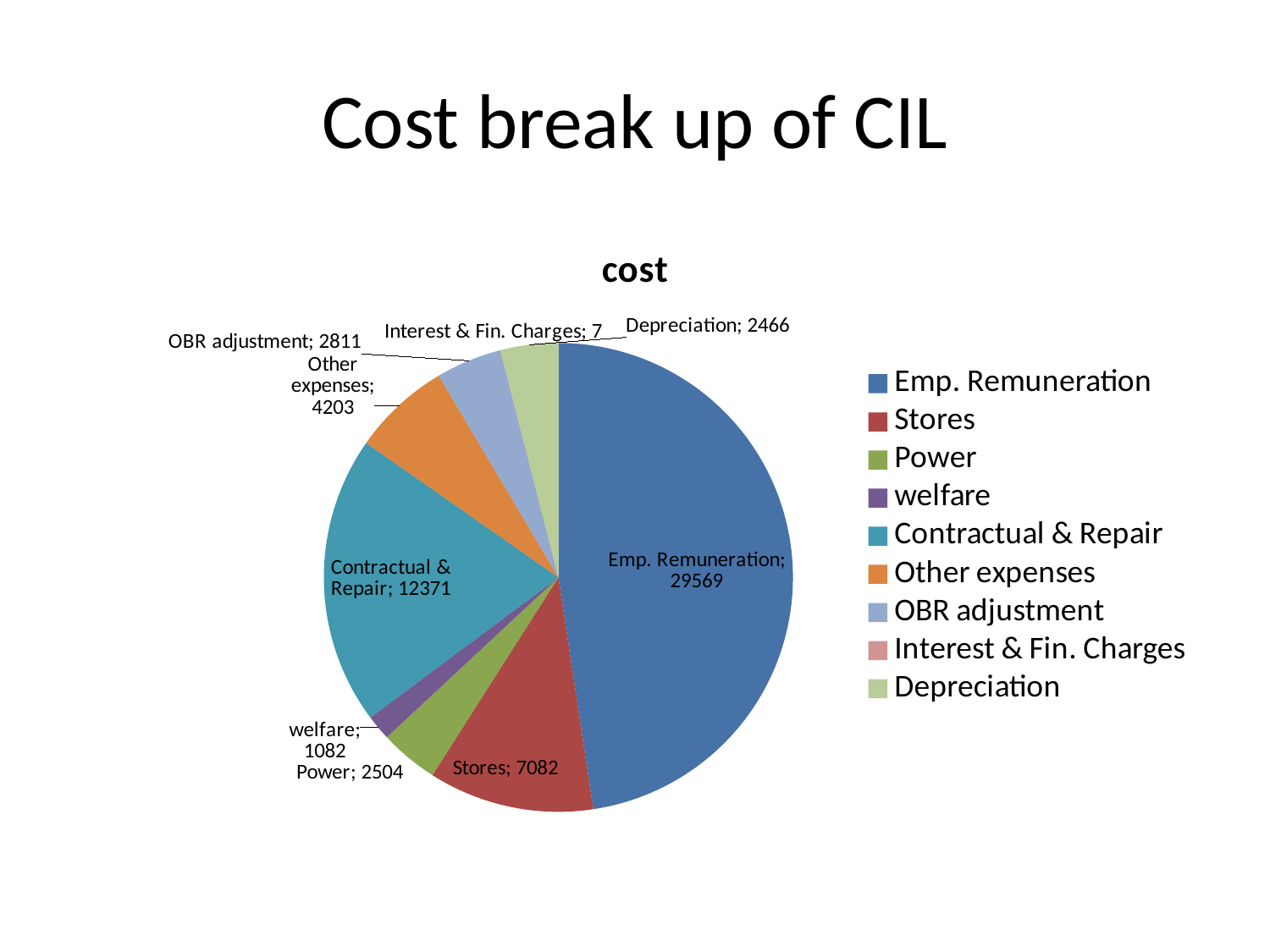
What is the difference between the values for OBR adjustment and Depreciation? 345 How many categories does the pie chart show? 9 What is the value for Contractual & Repair in the pie chart? 12371 Which is larger, the value for Power or the value for welfare? Power Which category has the smallest slice in the pie chart? Interest & Fin. Charges What is the value for OBR adjustment in the pie chart? 2811 What is the value for Interest & Fin. Charges in the pie chart? 7 What kind of chart is shown on the slide? Pie chart What is the value for Emp. Remuneration in the pie chart? 29569 What is the title of the chart? cost Which category has the largest slice in the pie chart? Emp. Remuneration What is the difference between the values for Contractual & Repair and Stores? 5289